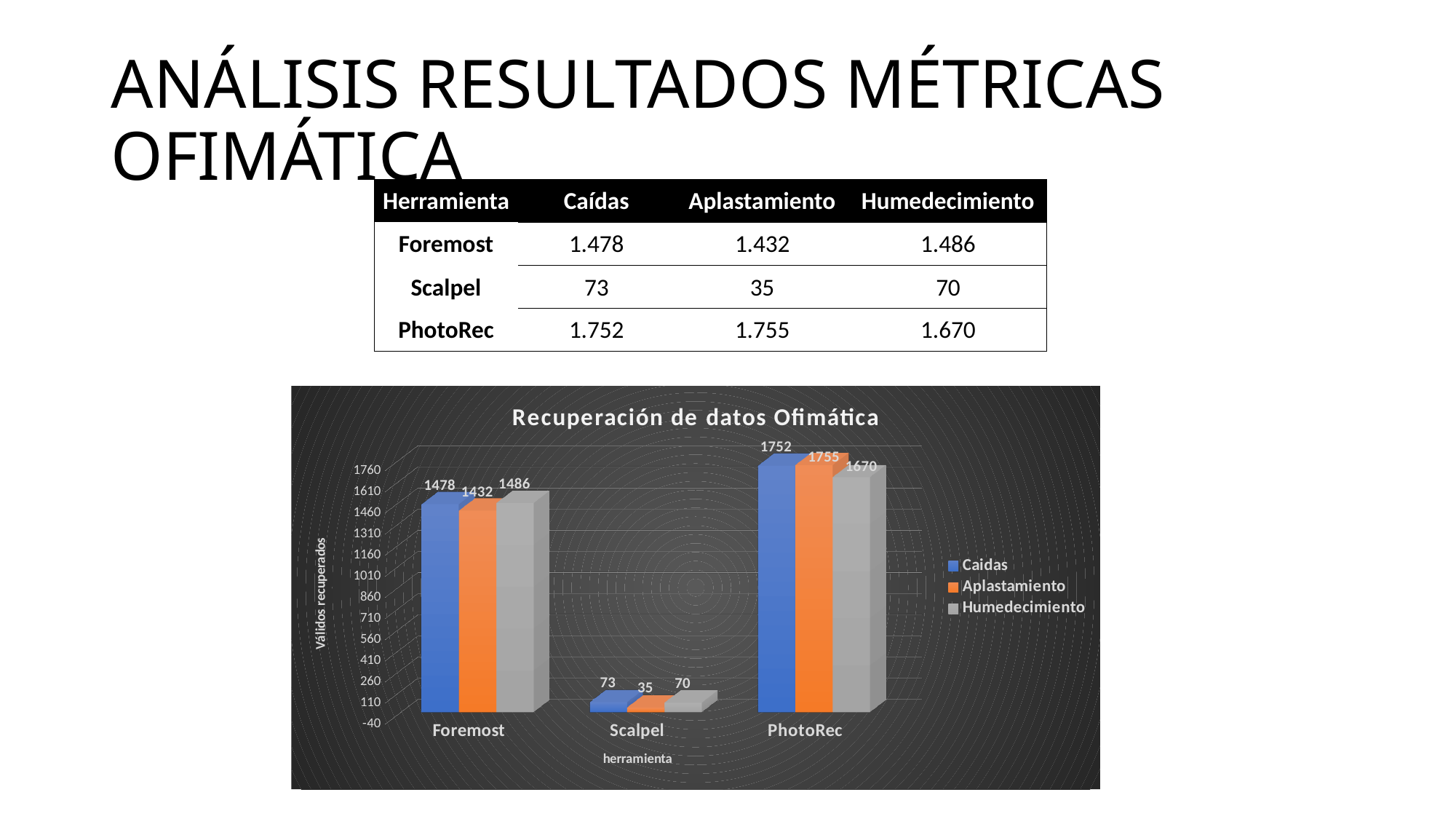
What is the Aplastamiento value for Scalpel in the chart? 35 Is the Caidas value for Scalpel greater or less than 260? less Which tool has the lowest Humedecimiento value in the chart? Scalpel What is the Caidas value for Foremost in the chart? 1478 What is the difference between the Aplastamiento values for PhotoRec and Foremost in the chart? 323 How many tools (categories) are shown on the x axis of the chart? 3 Which tool has the highest Caidas value in the chart? PhotoRec How many series does the chart legend list? 3 What is the title of the chart? Recuperación de datos Ofimática Which is larger in the chart: the Humedecimiento value for Foremost or the Caidas value for Foremost? Humedecimiento for Foremost What type of chart is shown on the slide? bar chart What is the Humedecimiento value for PhotoRec in the chart? 1670